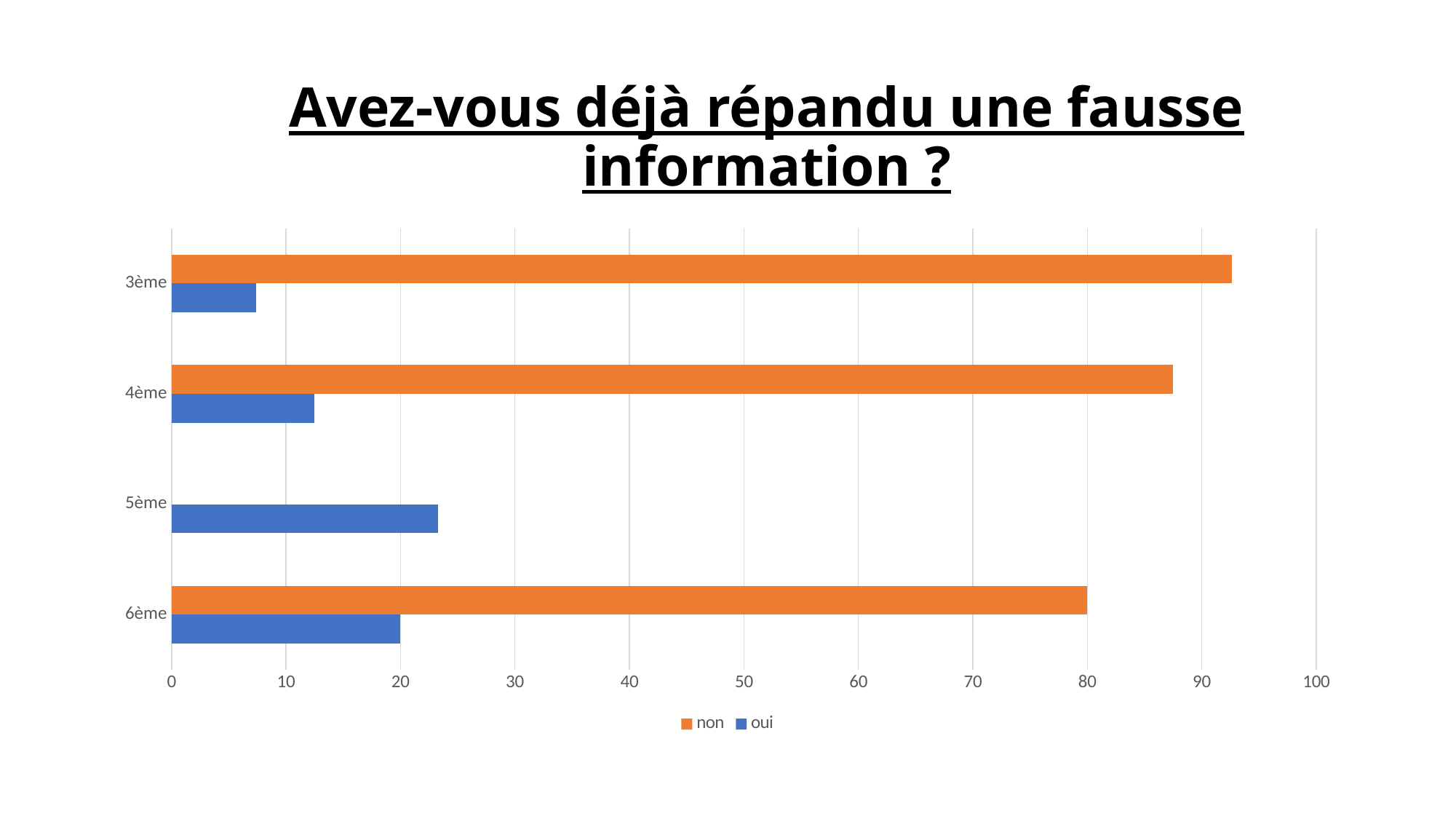
Is the 'non' value for 3ème greater or less than 90? greater What are the two entries in the legend? non, oui Which category has the highest value for the 'non' series? 3ème Which category has the highest value for the 'oui' series? 5ème Is the 'oui' value for 5ème greater or less than 20? greater Is the 'oui' value for 4ème greater or less than 10? greater Which category has the lowest value for the 'oui' series? 3ème Which is larger: the 'non' value for 4ème or the 'non' value for 6ème? 4ème How many series does the legend list? 2 What is the 'non' value for 6ème? 80 How many categories are shown on the vertical axis? 4 What kind of chart is shown on the slide? bar chart